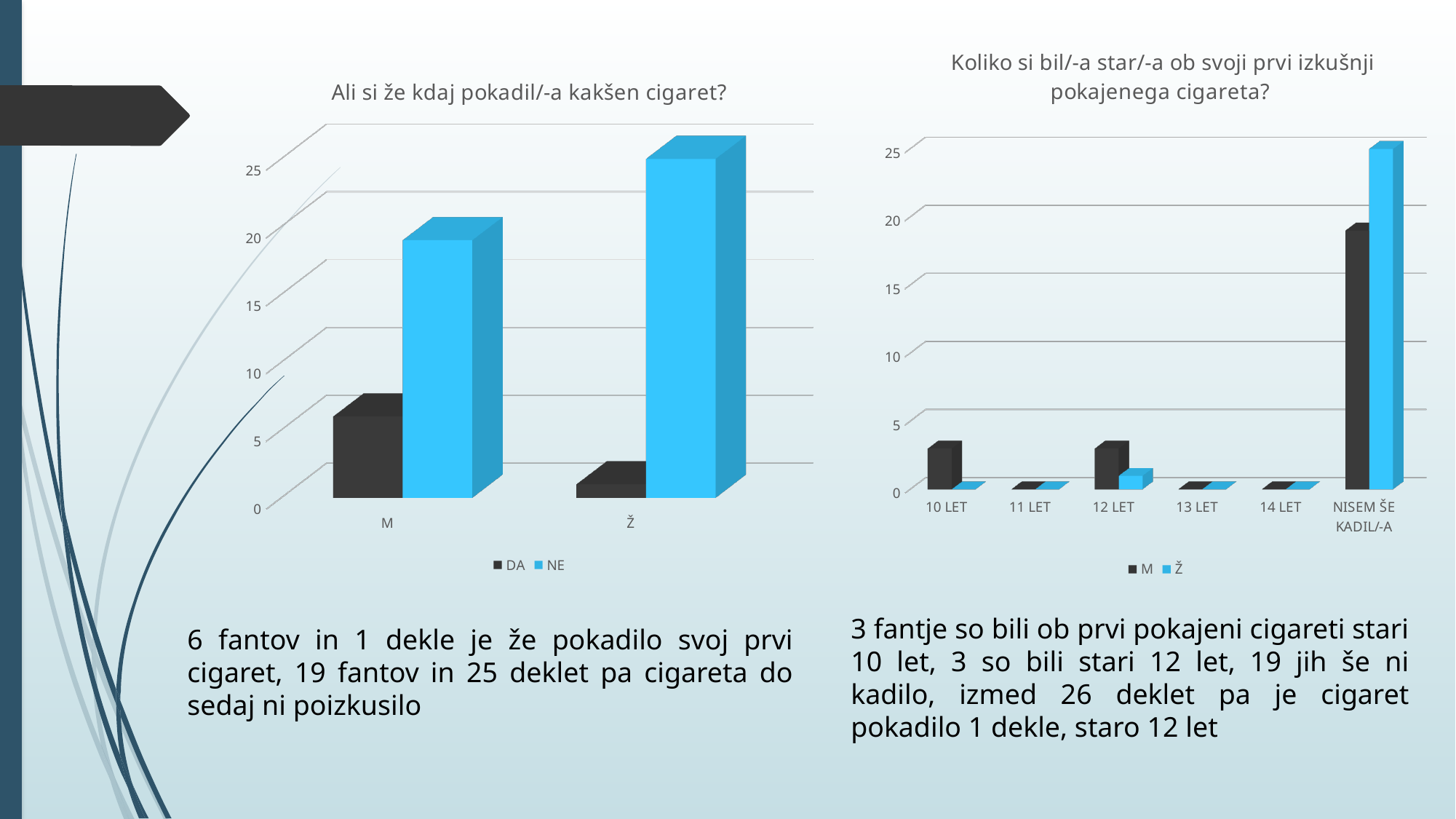
In the left chart "Ali si že kdaj pokadil/-a kakšen cigaret?", what is the NE value for Ž? 25 In the left chart "Ali si že kdaj pokadil/-a kakšen cigaret?", is the NE value for M greater or less than 15? greater In the left chart "Ali si že kdaj pokadil/-a kakšen cigaret?", is the DA value for M greater or less than 10? less In the left chart "Ali si že kdaj pokadil/-a kakšen cigaret?", how many series does the legend list? 2 In the right chart "Koliko si bil/-a star/-a ob svoji prvi izkušnji pokajenega cigareta?", how many categories are shown on the x axis? 6 In the right chart "Koliko si bil/-a star/-a ob svoji prvi izkušnji pokajenega cigareta?", is the M value for NISEM ŠE KADIL/-A greater or less than 15? greater In the right chart "Koliko si bil/-a star/-a ob svoji prvi izkušnji pokajenega cigareta?", which category has the highest M value? NISEM ŠE KADIL/-A What kind of chart is the left chart titled "Ali si že kdaj pokadil/-a kakšen cigaret?"? bar chart In the left chart "Ali si že kdaj pokadil/-a kakšen cigaret?", how many categories are shown on the x axis? 2 In the left chart "Ali si že kdaj pokadil/-a kakšen cigaret?", which has the larger DA value, M or Ž? M In the right chart "Koliko si bil/-a star/-a ob svoji prvi izkušnji pokajenega cigareta?", what is the Ž value for NISEM ŠE KADIL/-A? 25 In the right chart "Koliko si bil/-a star/-a ob svoji prvi izkušnji pokajenega cigareta?", what are the two legend entries? M and Ž